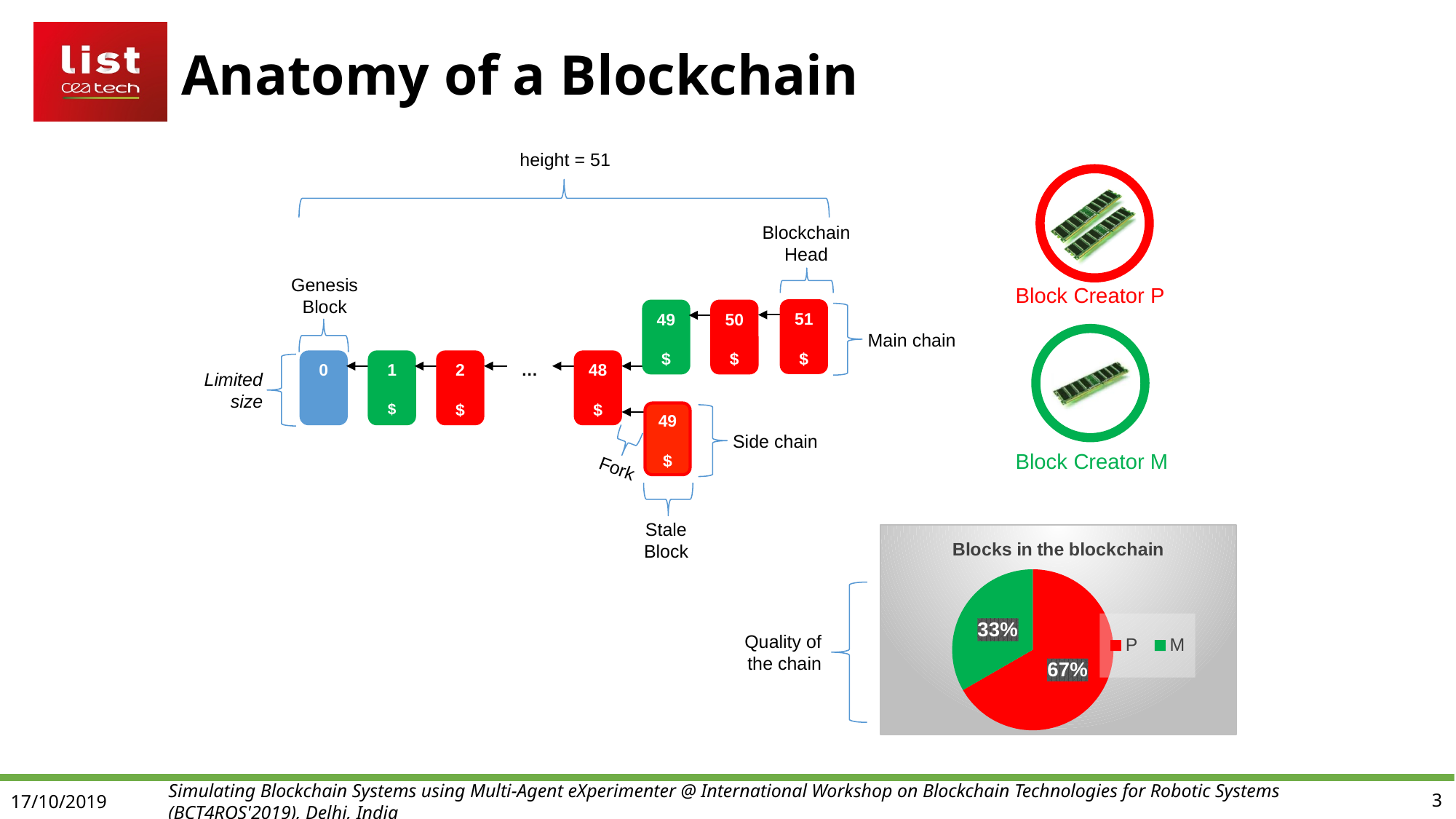
In the 'Blocks in the blockchain' chart, what colour is the slice for M? green In the 'Blocks in the blockchain' chart, is the share for P greater or less than 50%? greater In the 'Blocks in the blockchain' chart, what share of blocks is attributed to P? 67% In the 'Blocks in the blockchain' chart, what is the difference in percentage points between the P and M slices? 34 In the 'Blocks in the blockchain' chart, what share of blocks is attributed to M? 33% In the 'Blocks in the blockchain' chart, which category has the smallest slice? M How many entries does the legend of the 'Blocks in the blockchain' chart list? 2 How many slices does the 'Blocks in the blockchain' pie chart have? 2 In the 'Blocks in the blockchain' chart, which category has the largest slice? P What kind of chart is 'Blocks in the blockchain'? pie chart In the 'Blocks in the blockchain' chart, is the slice for P larger or smaller than the slice for M? larger What is the title of the pie chart on the slide? Blocks in the blockchain